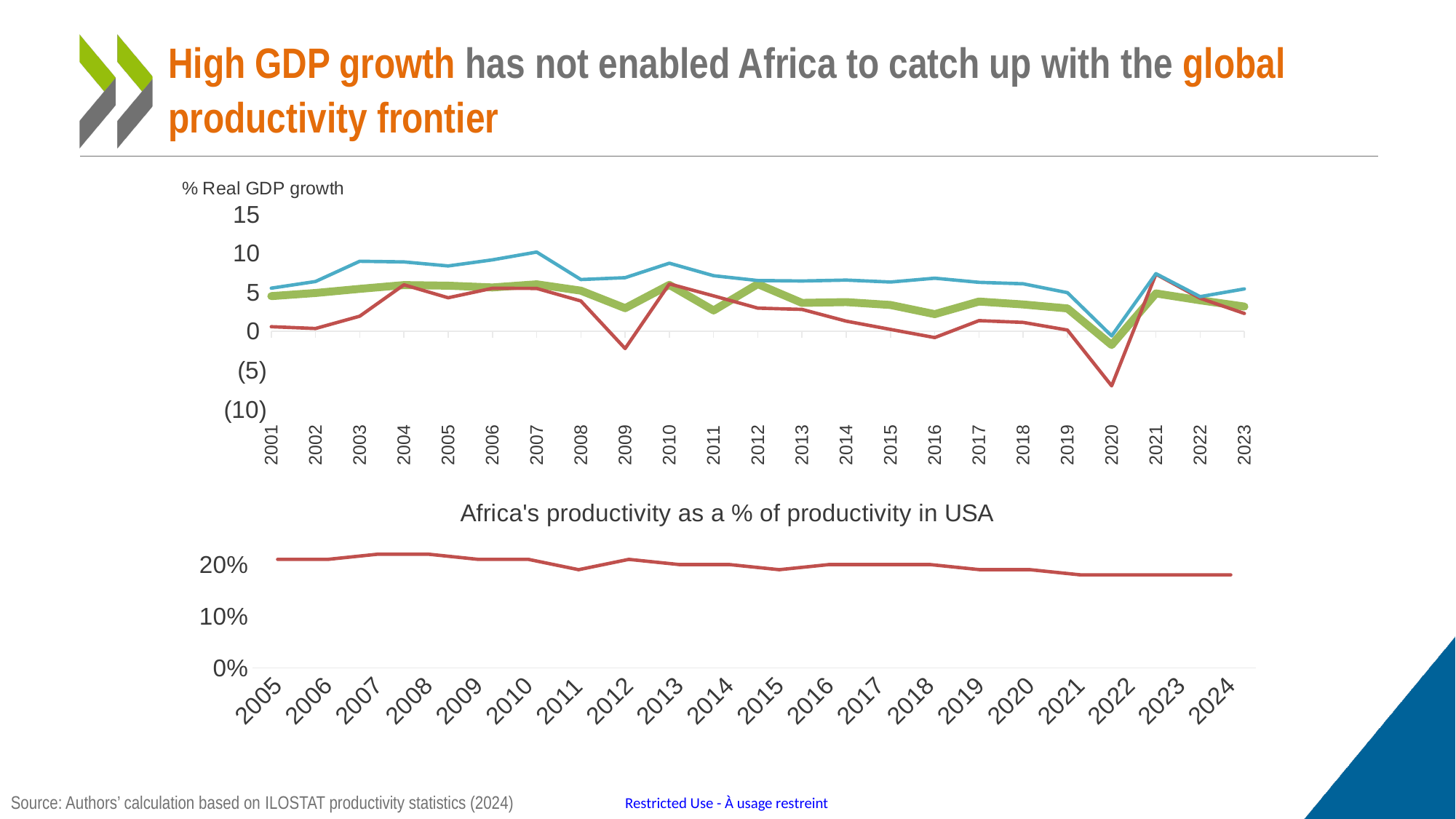
In the bottom chart ('Africa's productivity as a % of productivity in USA'), does the line overall rise or fall from 2005 to 2024? fall In the top chart ('% Real GDP growth'), is the value of the red line in 2020 greater or less than 0? less In the top chart ('% Real GDP growth'), is the value of the red line in 2009 greater or less than 0? less In the top chart ('% Real GDP growth'), what is the first year on the x axis? 2001 In the bottom chart ('Africa's productivity as a % of productivity in USA'), how many years are shown on the x axis? 20 What kind of chart is the top chart labelled '% Real GDP growth'? line chart In the bottom chart ('Africa's productivity as a % of productivity in USA'), is the value for 2024 greater or less than 20%? less What is the title of the bottom chart? Africa's productivity as a % of productivity in USA What kind of chart is the bottom chart ('Africa's productivity as a % of productivity in USA')? line chart In the top chart ('% Real GDP growth'), how many lines are plotted? 3 In the top chart ('% Real GDP growth'), how many years are shown on the x axis? 23